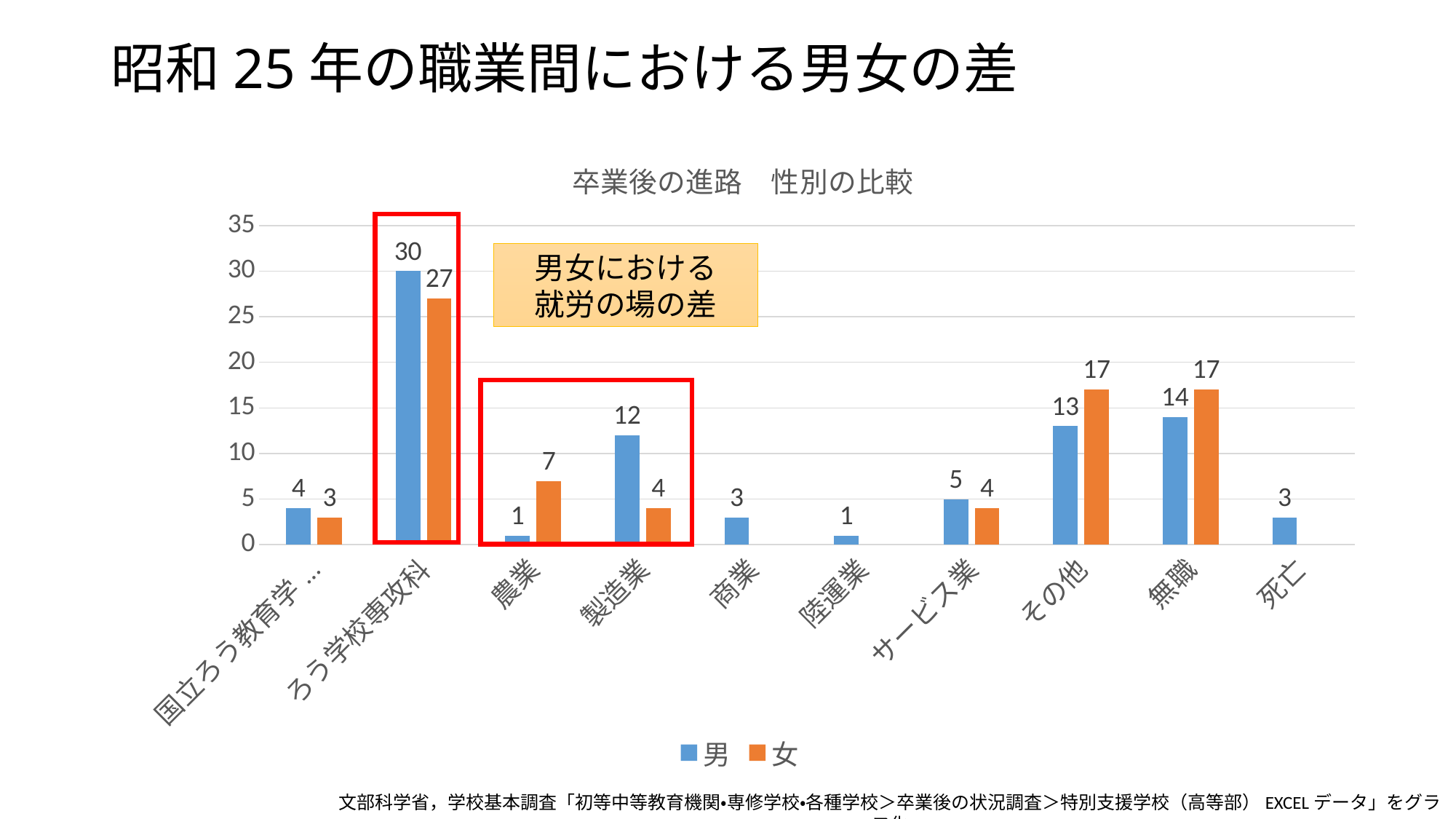
Which colour represents the 女 series? orange What is the value for 男 in the ろう学校専攻科 category? 30 What is the title of the chart? 卒業後の進路 性別の比較 What type of chart is shown on the slide? bar chart What is the difference between 男 and 女 in the 製造業 category? 8 What is the difference between 女 and 男 in the 無職 category? 3 Which is larger in the その他 category, 男 or 女? 女 How many categories are shown on the x axis? 10 What is the value for 女 in the 農業 category? 7 Which category has the highest value for 女? ろう学校専攻科 How many series does the legend list? 2 What is the value for 男 in the 製造業 category? 12